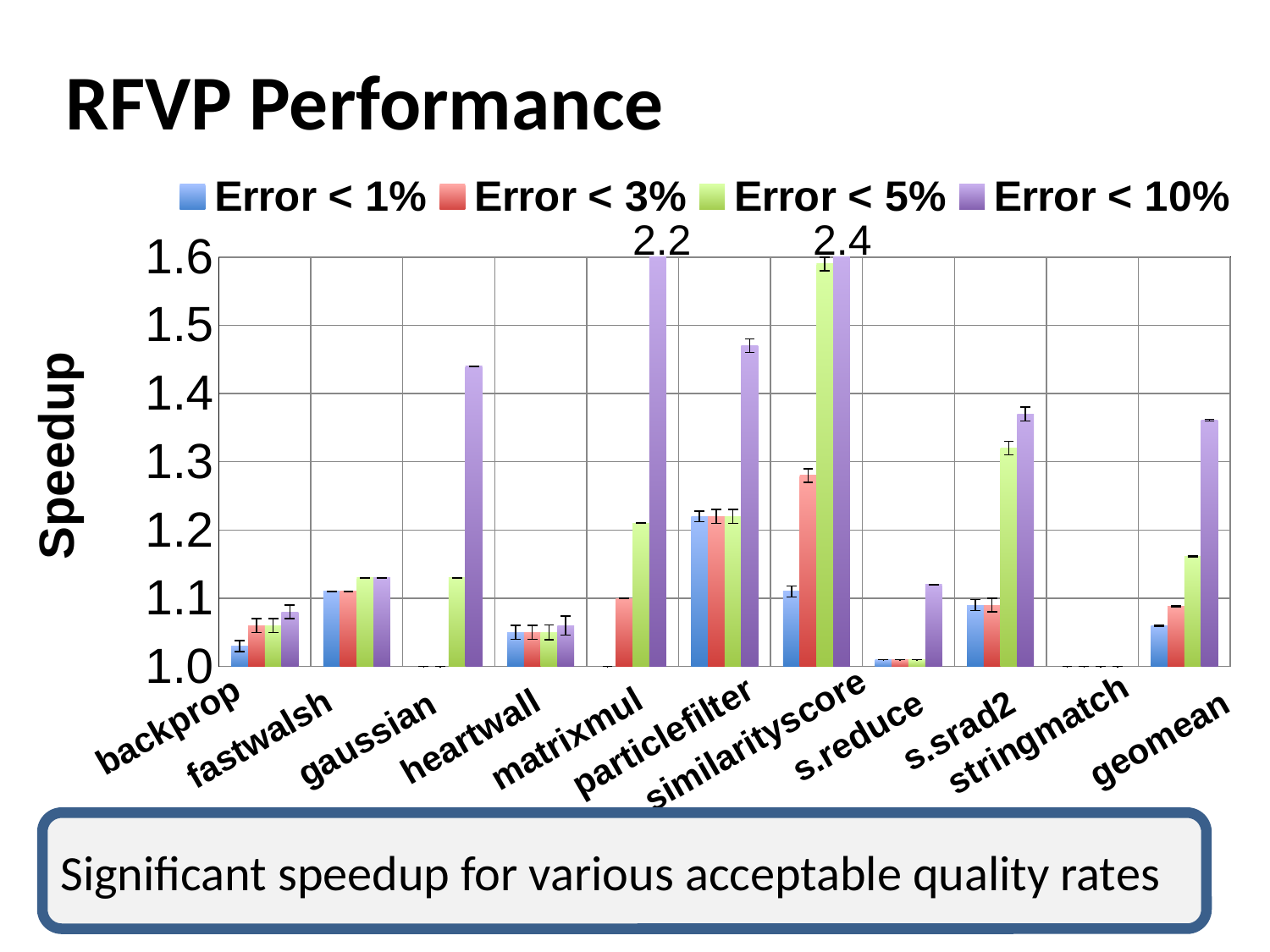
What kind of chart is shown on the slide? bar chart What is the speedup for similarityscore with Error < 10%? 2.4 Is the Error < 5% speedup for s.srad2 greater or less than 1.3? greater Which category has the highest Error < 10% speedup? similarityscore How many series does the legend list? 4 What is the label of the y axis? Speedup Which is larger: the Error < 10% speedup for matrixmul or for similarityscore? similarityscore How many categories are shown along the x axis? 11 What is the difference between the Error < 10% speedups of similarityscore and matrixmul? 0.2 Is the Error < 10% speedup for geomean greater or less than 1.4? less What is the speedup for matrixmul with Error < 10%? 2.2 Is the Error < 10% speedup for heartwall greater or less than 1.4? less